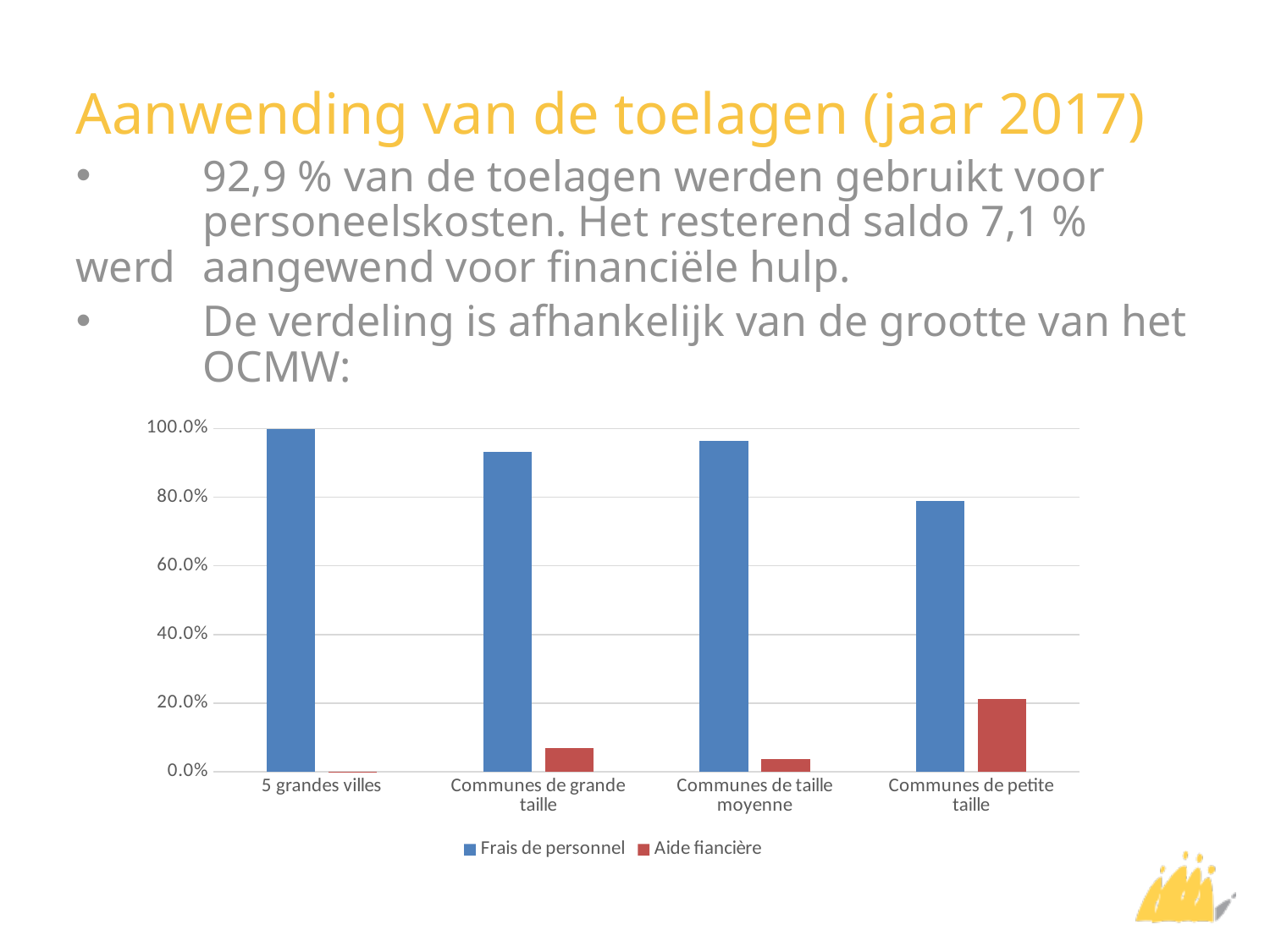
Which category has the lowest value for Aide fiancière? 5 grandes villes What are the two series named in the chart's legend? Frais de personnel and Aide fiancière Is the value for Aide fiancière in Communes de petite taille greater or less than 20.0%? greater What kind of chart is shown on the slide? bar chart How many series does the chart's legend list? 2 Is the value for Frais de personnel in Communes de grande taille greater or less than 80.0%? greater Which category has the highest value for Aide fiancière? Communes de petite taille Which is larger: Aide fiancière for Communes de grande taille or Aide fiancière for Communes de taille moyenne? Communes de grande taille Which category has the lowest value for Frais de personnel? Communes de petite taille Which category has the highest value for Frais de personnel? 5 grandes villes Is the value for Frais de personnel in Communes de petite taille greater or less than 80.0%? less How many categories are shown on the x axis of the chart? 4